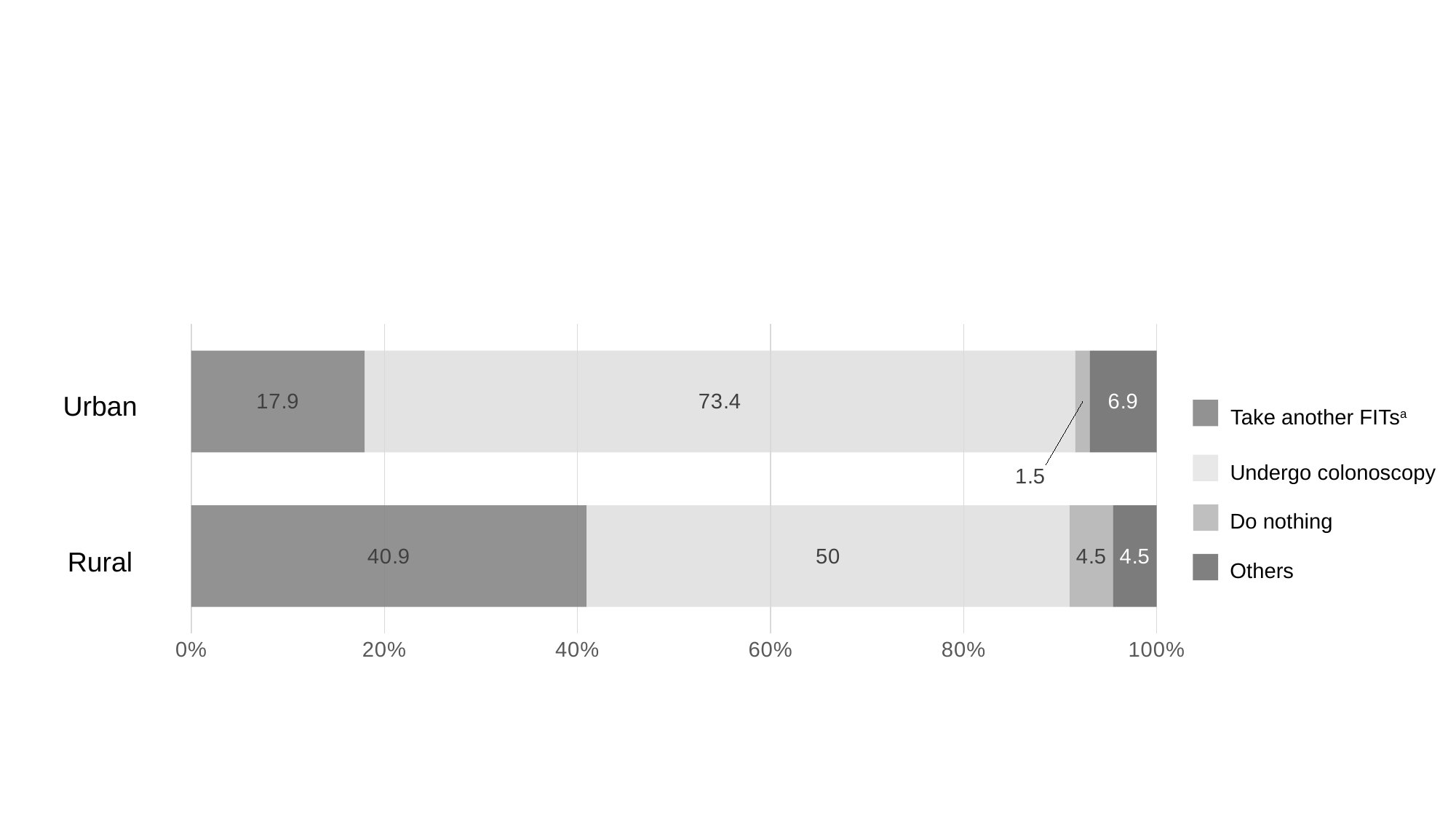
Which category has the higher value for Take another FITs, Urban or Rural? Rural What is the difference between the Take another FITs values for Rural and Urban? 23 What is the value for Take another FITs in the Urban category? 17.9 What is the value for Do nothing in the Urban category? 1.5 What is the difference between the Undergo colonoscopy values for Urban and Rural? 23.4 Which series has the largest segment in the Urban bar? Undergo colonoscopy How many categories are shown on the chart? 2 What is the value for Undergo colonoscopy in the Rural category? 50 Which category has the higher value for Undergo colonoscopy, Urban or Rural? Urban What is the value for Others in the Rural category? 4.5 How many series does the legend list? 4 What kind of chart is shown on the slide? Stacked bar chart